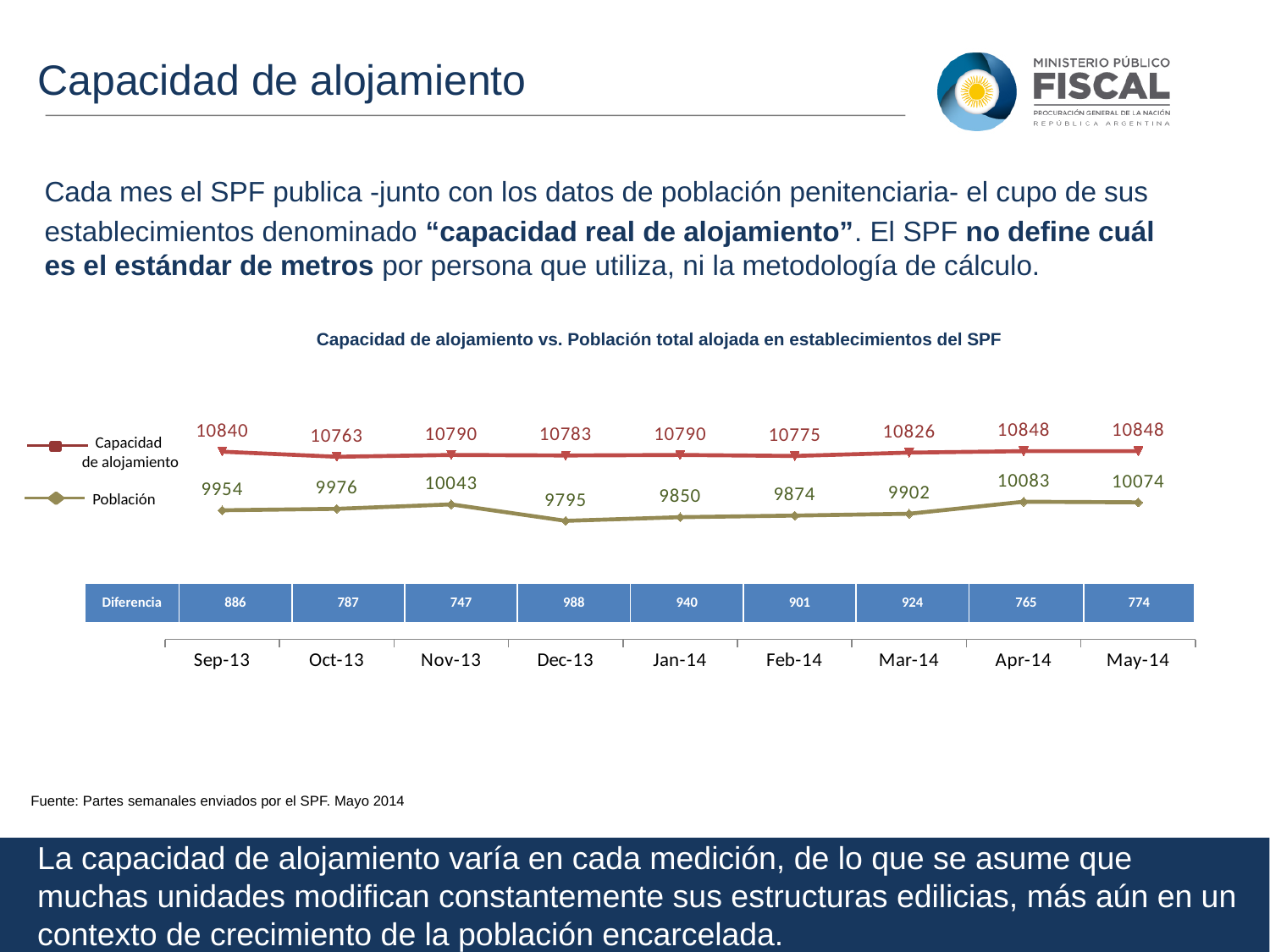
What is the value of Población in Dec-13? 9795 In which month is Población at its lowest? Dec-13 What is the Diferencia value shown for Mar-14? 924 How many months are plotted on the x axis? 9 What kind of chart is shown? Line chart In which month is Población at its highest? Apr-14 In which month is Capacidad de alojamiento at its lowest? Oct-13 Which is larger in Jan-14, Capacidad de alojamiento or Población? Capacidad de alojamiento What is the value of Capacidad de alojamiento in Sep-13? 10840 What is the difference between Capacidad de alojamiento and Población in Nov-13? 747 How many series does the legend list? 2 What is the title of the chart? Capacidad de alojamiento vs. Población total alojada en establecimientos del SPF